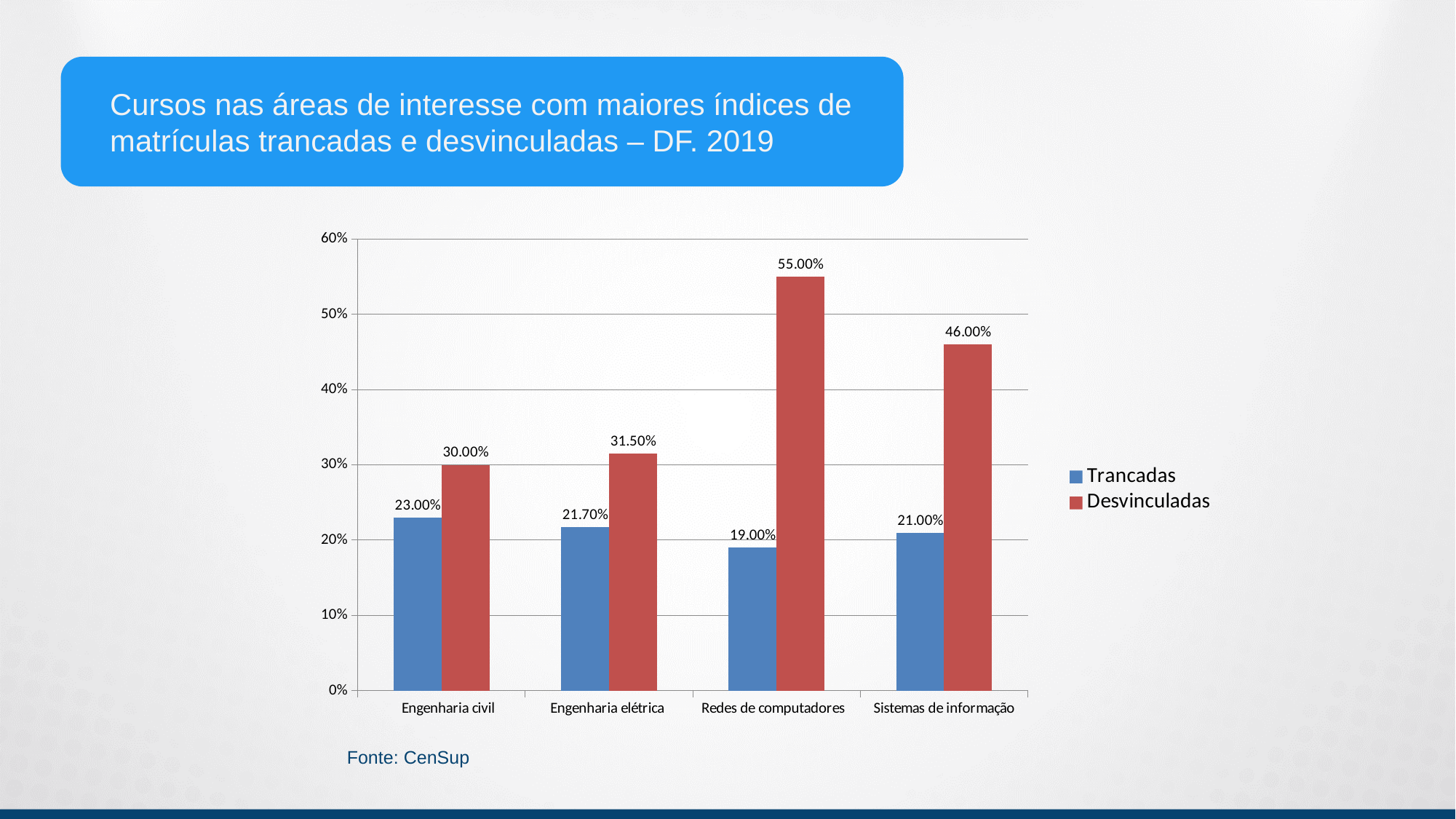
Which course has the highest Desvinculadas value? Redes de computadores What is the Desvinculadas value for Redes de computadores? 55.00% What is the Trancadas value for Sistemas de informação? 21.00% What is the Desvinculadas value for Engenharia elétrica? 31.50% How many courses are shown on the x axis? 4 What is the Trancadas value for Engenharia civil? 23.00% Which is larger for Sistemas de informação: Trancadas or Desvinculadas? Desvinculadas What kind of chart is shown on the slide? Bar chart How many series does the legend list? 2 Which course has the lowest Trancadas value? Redes de computadores What colour are the Desvinculadas bars? Red What is the difference between the Desvinculadas and Trancadas values for Redes de computadores? 36.00%